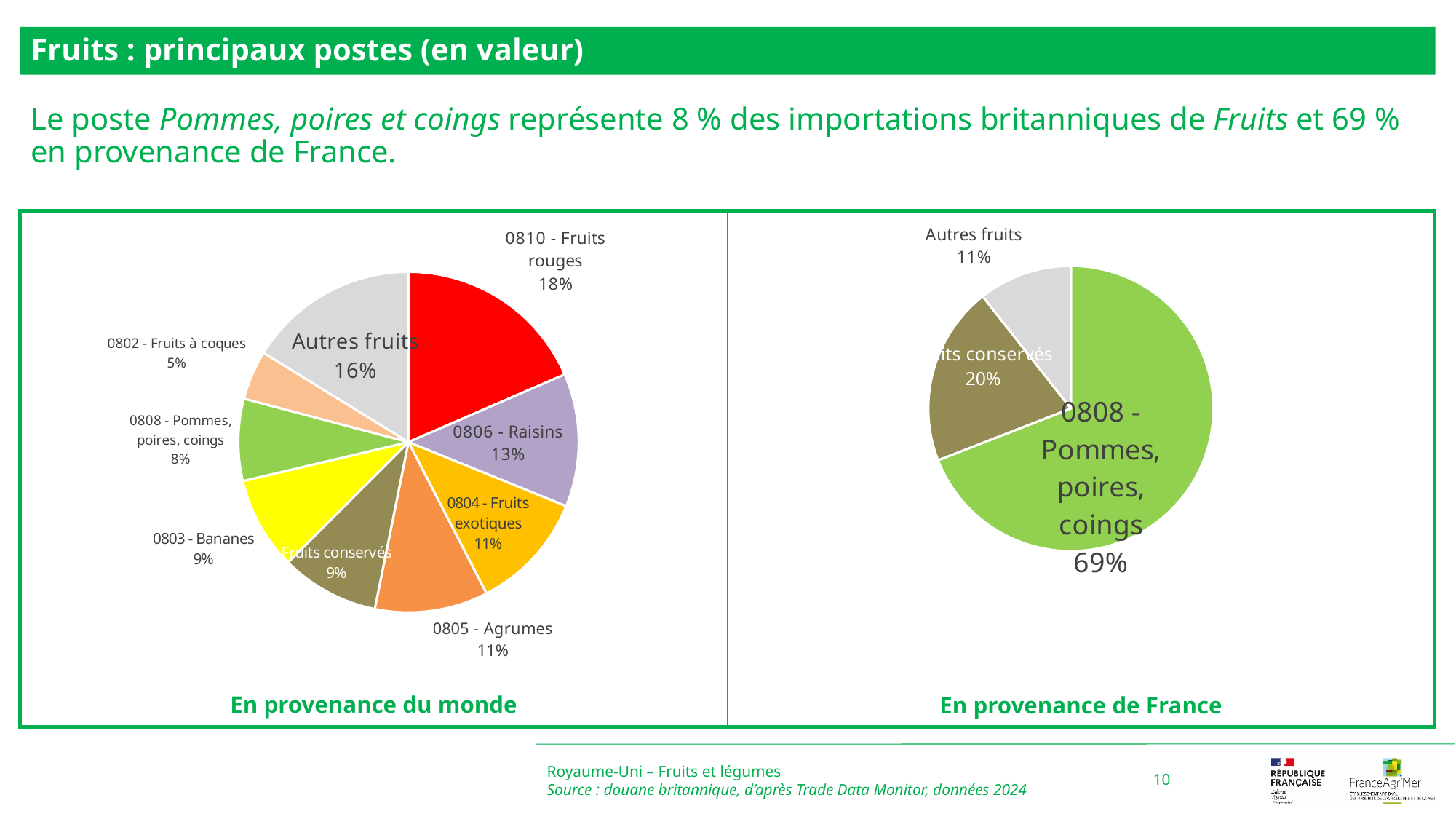
In the 'En provenance du monde' pie chart, what is the difference in share between '0810 - Fruits rouges' and '0808 - Pommes, poires, coings'? 10 percentage points In the 'En provenance du monde' pie chart, how many slices are there? 9 In the 'En provenance de France' pie chart, what share does '0808 - Pommes, poires, coings' have? 69% In the 'En provenance du monde' pie chart, what share does '0810 - Fruits rouges' have? 18% In the 'En provenance du monde' pie chart, which category has the largest share? 0810 - Fruits rouges What type of chart is used on the right side of the slide, 'En provenance de France'? Pie chart In the 'En provenance du monde' pie chart, what share does '0806 - Raisins' have? 13% In the 'En provenance de France' pie chart, how many slices are there? 3 In the 'En provenance du monde' pie chart, which category has the smallest share? 0802 - Fruits à coques In the 'En provenance du monde' pie chart, which has a larger share: '0806 - Raisins' or '0803 - Bananes'? 0806 - Raisins In the 'En provenance de France' pie chart, what share does 'Fruits conservés' have? 20% In the 'En provenance du monde' pie chart, what share does '0802 - Fruits à coques' have? 5%